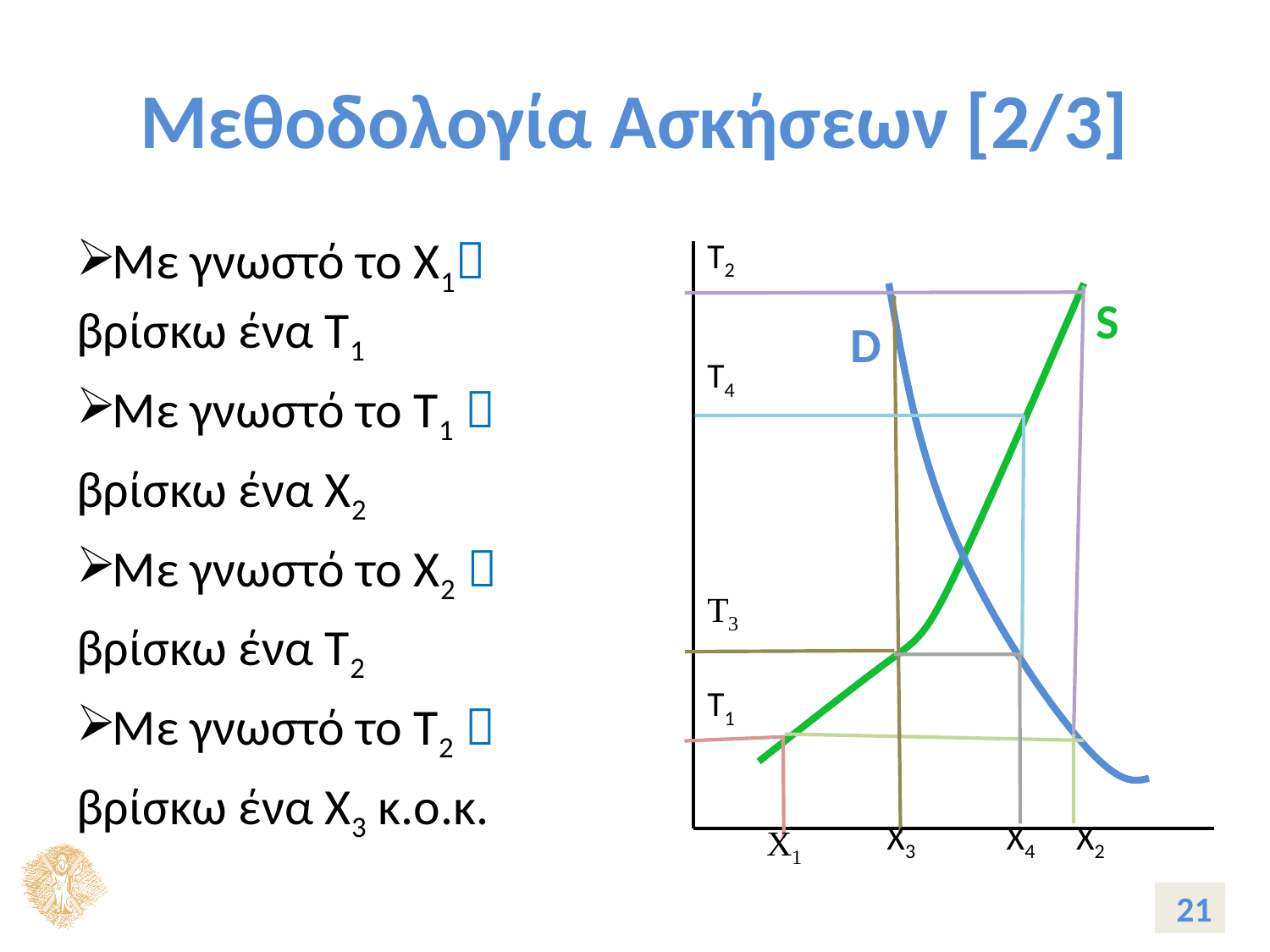
Which is higher on the vertical axis, T4 or T3? T4 Which labeled point on the x axis is furthest to the right? X2 What are the labels of the two curves on the chart? D and S What kind of chart is shown on the slide? line chart Does the curve labeled S rise or fall as you move to the right along the x axis? rises Does the curve labeled D rise or fall as you move to the right along the x axis? falls What colour is the curve labeled S? green How many curves are plotted on the chart? 2 Which labeled level on the vertical axis is the lowest? T1 Which labeled level on the vertical axis is the highest? T2 Which labeled point on the x axis is furthest to the left? X1 How many labeled points are marked on the x axis? 4